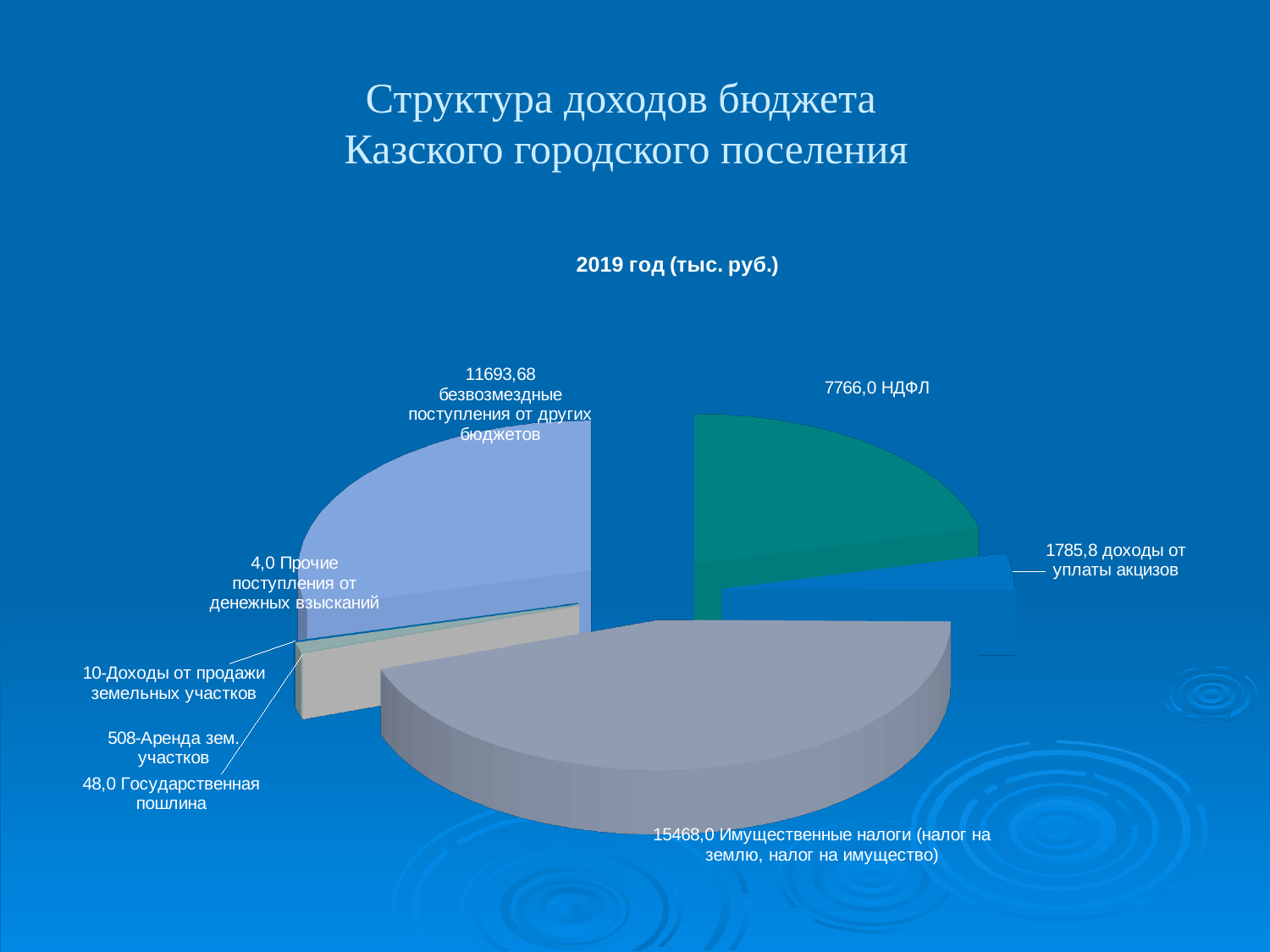
What is the difference between Имущественные налоги and безвозмездные поступления от других бюджетов? 3774,32 Which is larger: НДФЛ or доходы от уплаты акцизов? НДФЛ What is the value for безвозмездные поступления от других бюджетов? 11693,68 How many categories are shown in the pie chart? 8 What is the value for Имущественные налоги (налог на землю, налог на имущество)? 15468,0 What is the subtitle of the pie chart indicating the year and units? 2019 год (тыс. руб.) What is the value for Государственная пошлина? 48,0 Which category has the smallest value in the pie chart? Прочие поступления от денежных взысканий What is the value for НДФЛ in the pie chart? 7766,0 Which category has the largest slice in the pie chart? Имущественные налоги (налог на землю, налог на имущество) What kind of chart is shown on the slide? Pie chart What is the value for доходы от уплаты акцизов? 1785,8